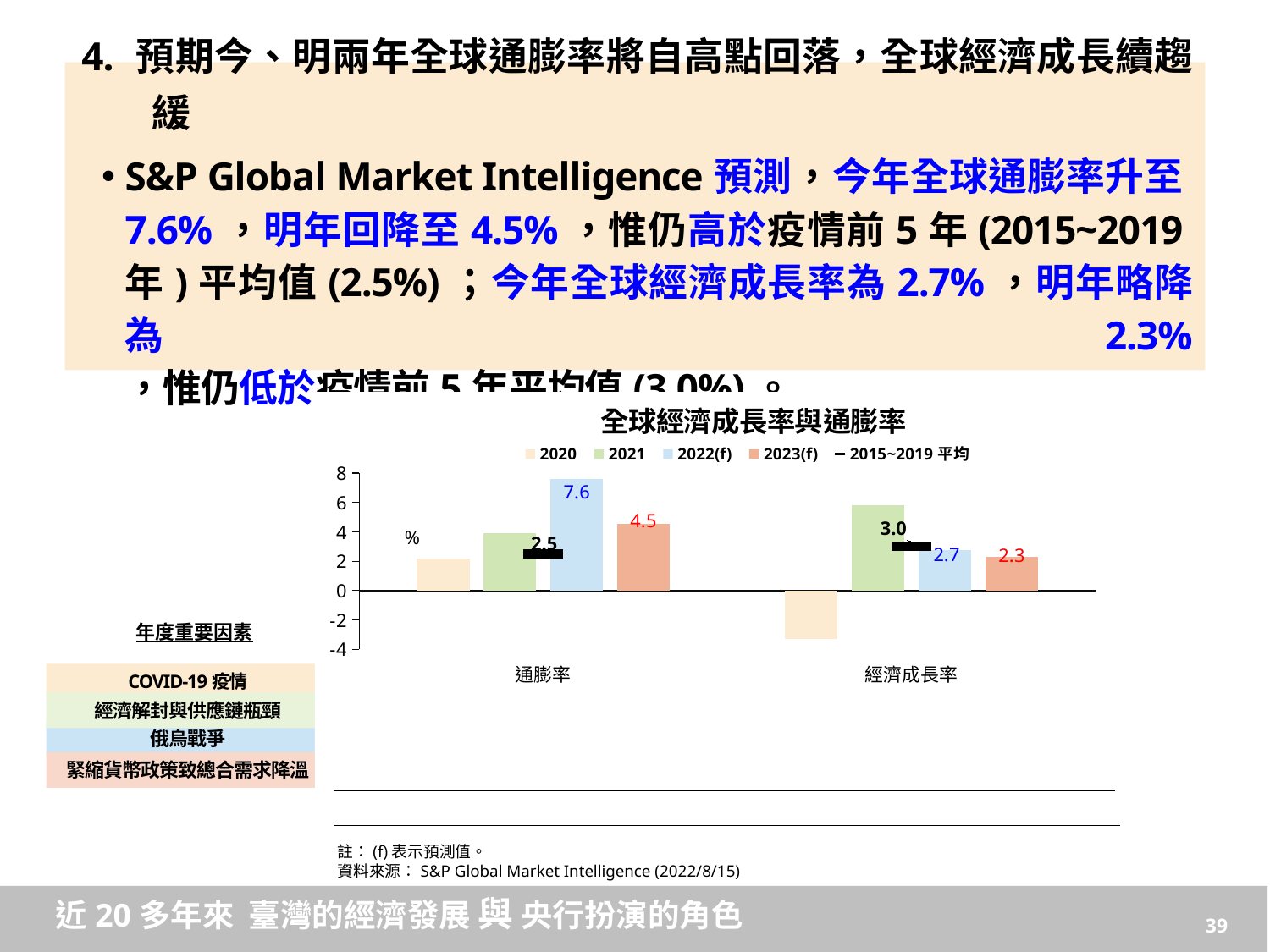
Which year has the highest 通膨率 bar? 2022(f) What is the 2015~2019 平均 value shown for 經濟成長率? 3.0 What is the difference between the 2022(f) and 2023(f) values for 通膨率? 3.1 What is the value of the 2022(f) bar for 通膨率? 7.6 Is the 2020 value for 經濟成長率 greater or less than 0? less What is the 2015~2019 平均 value shown for 通膨率? 2.5 Which year has the lowest 經濟成長率 bar? 2020 What is the difference between the 2022(f) and 2023(f) values for 經濟成長率? 0.4 What is the value of the 2022(f) bar for 經濟成長率? 2.7 What kind of chart is shown on the slide? combination bar and line chart What is the value of the 2023(f) bar for 通膨率? 4.5 How many entries does the legend list? 5